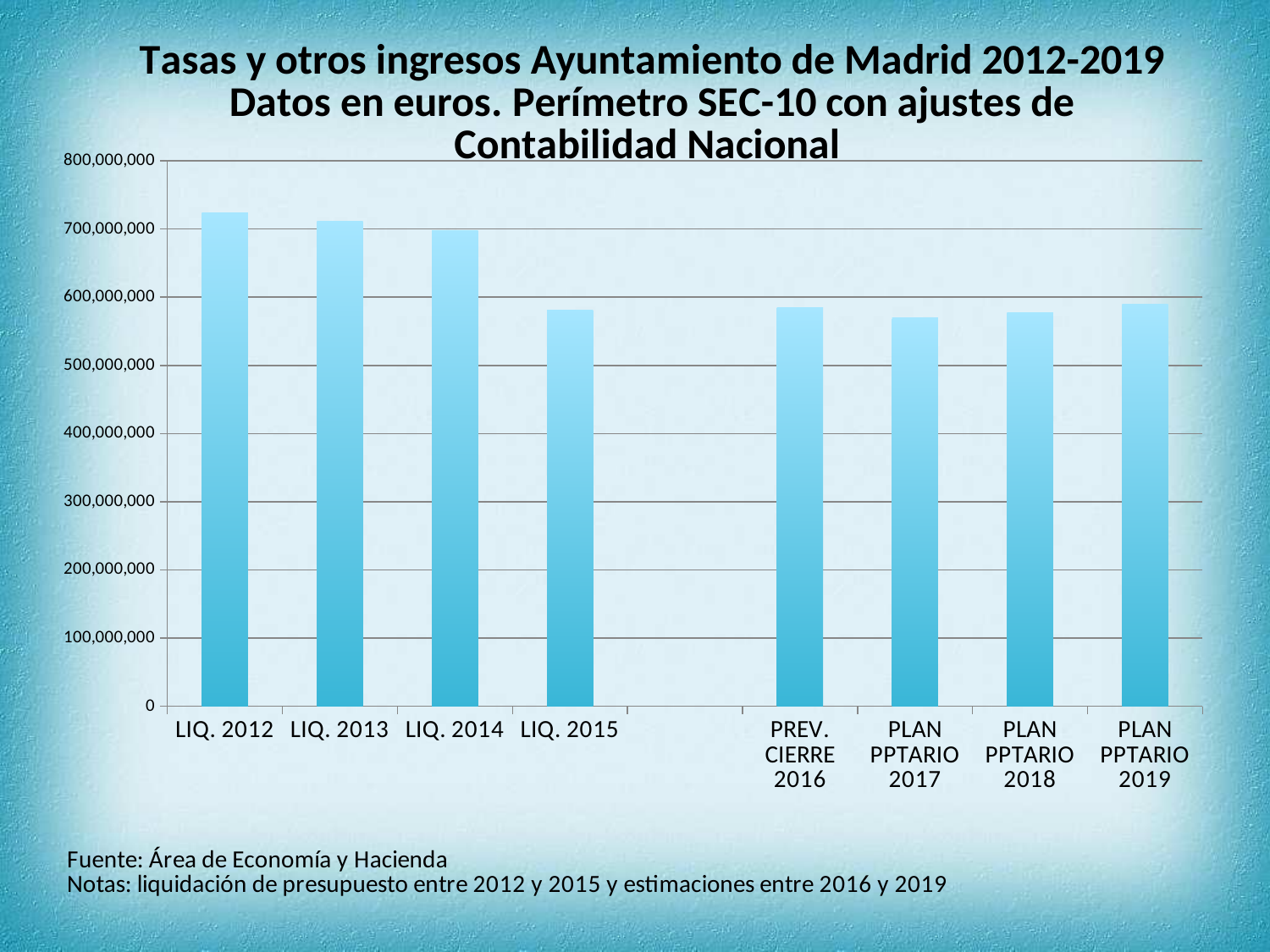
Is the value for PLAN PPTARIO 2017 greater or less than 600,000,000? less Which category has the highest value in the chart? LIQ. 2012 Which is larger, the value for LIQ. 2014 or the value for PLAN PPTARIO 2019? LIQ. 2014 Is the value for LIQ. 2012 greater or less than 700,000,000? greater How many bars (categories) are plotted in the chart? 8 According to the note below the chart, what is the source (Fuente) of the data? Área de Economía y Hacienda Is the value for LIQ. 2013 greater or less than 700,000,000? greater Which is larger, the value for LIQ. 2012 or the value for LIQ. 2015? LIQ. 2012 What kind of chart is shown on the slide? bar chart Do the values rise or fall from LIQ. 2012 to LIQ. 2015? fall What is the first line of the chart title? Tasas y otros ingresos Ayuntamiento de Madrid 2012-2019